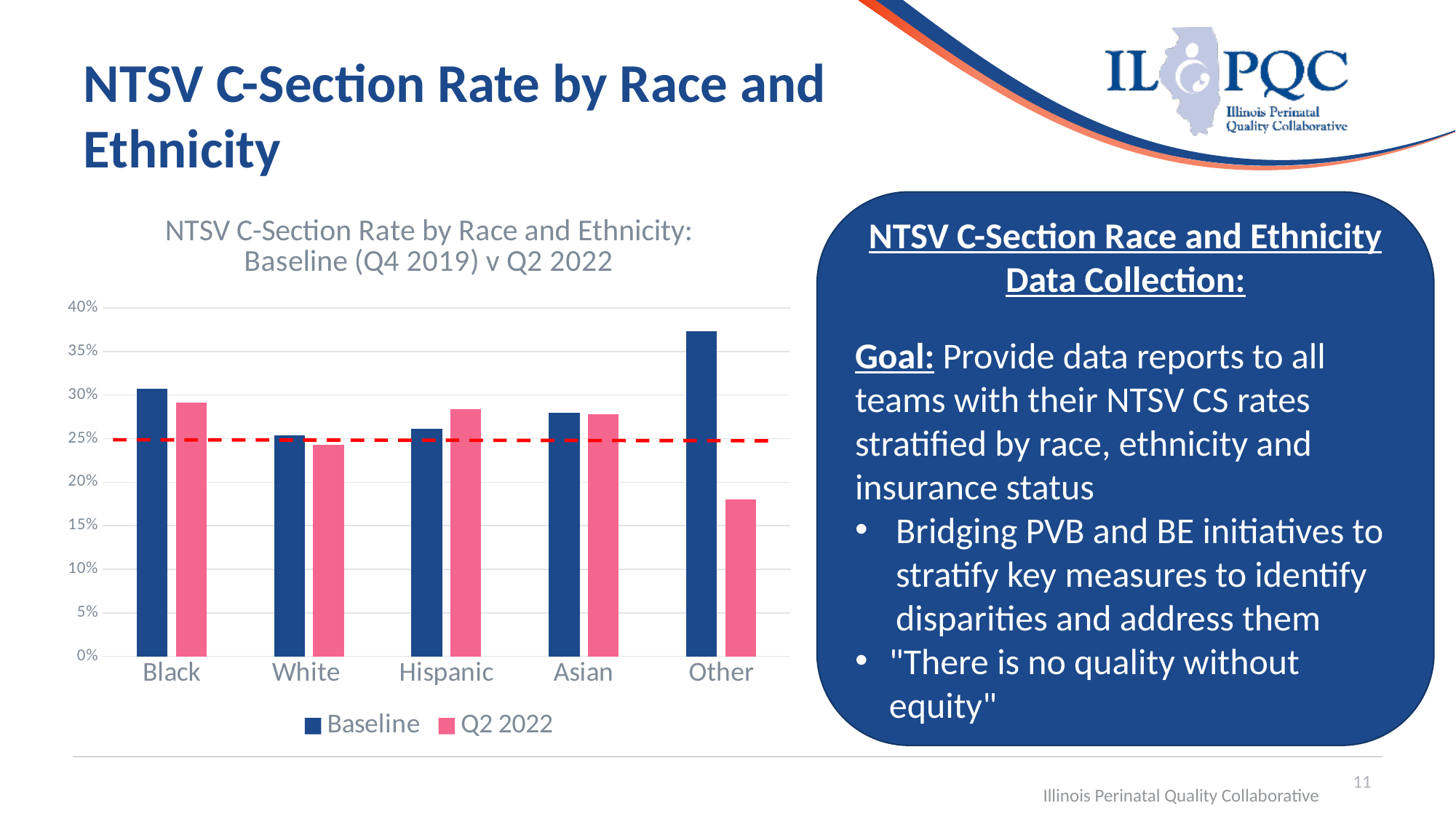
What are the two series named in the chart legend? Baseline and Q2 2022 How many race/ethnicity categories are shown on the x axis? 5 Which category has the lowest Q2 2022 value? Other Is the Baseline value for Other greater or less than 35%? greater What is the title of the chart? NTSV C-Section Rate by Race and Ethnicity: Baseline (Q4 2019) v Q2 2022 Which category has the highest Baseline value? Other For Hispanic, which is larger: the Baseline value or the Q2 2022 value? Q2 2022 How many series does the chart legend list? 2 Is the Q2 2022 value for Other greater or less than 20%? less Is the Q2 2022 value for Hispanic greater or less than 25%? greater What kind of chart is shown on the slide? bar chart For Black, which is larger: the Baseline value or the Q2 2022 value? Baseline